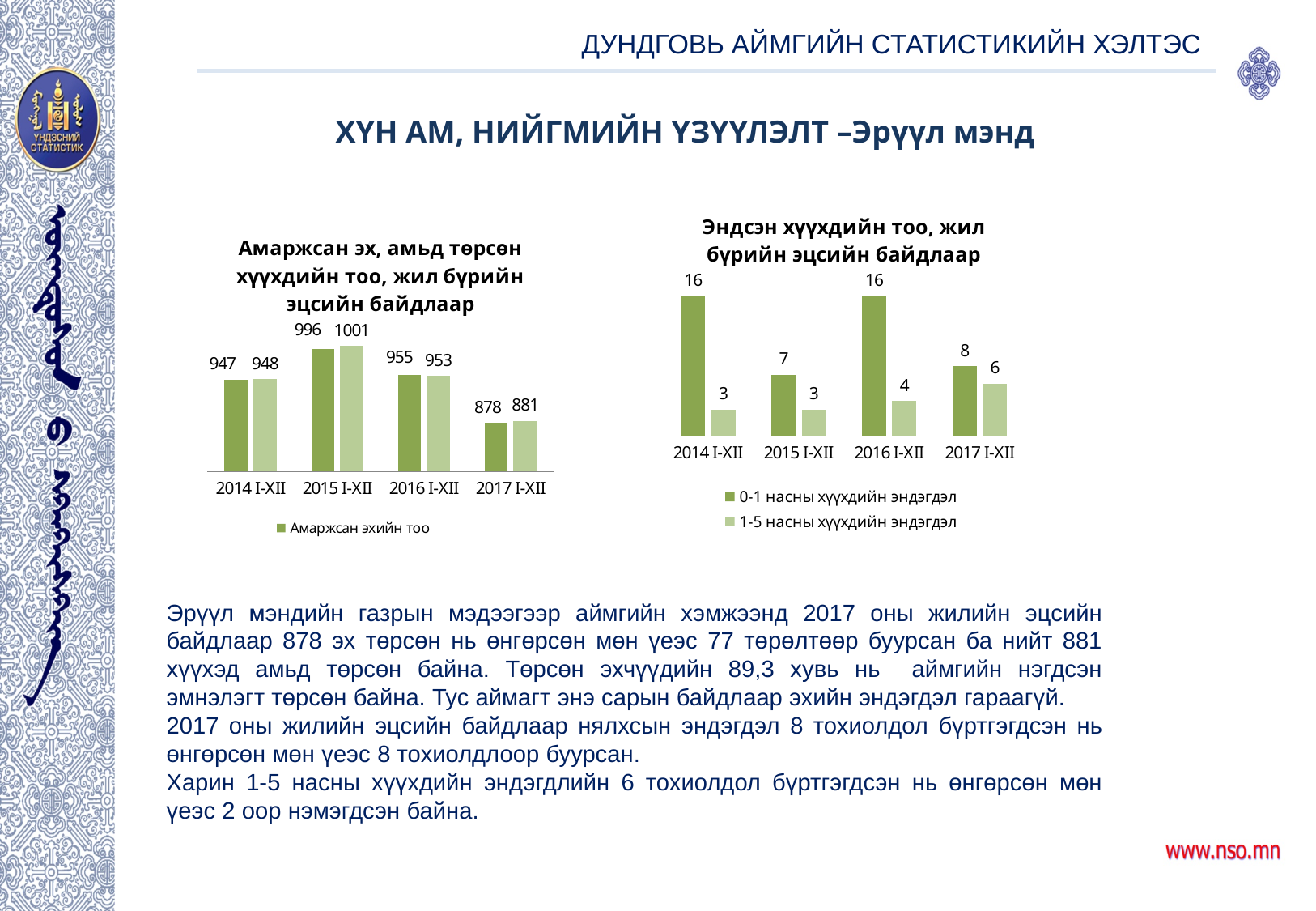
How many series does the legend of the right chart (Эндсэн хүүхдийн тоо) list? 2 In the right chart (Эндсэн хүүхдийн тоо), what is the difference between the 0-1 насны хүүхдийн эндэгдэл values for 2016 I-XII and 2017 I-XII? 8 In the left chart (Амаржсан эх, амьд төрсөн хүүхдийн тоо), which year has the lowest value for Амаржсан эхийн тоо? 2017 I-XII In the right chart (Эндсэн хүүхдийн тоо), which is larger in 2015 I-XII: 0-1 насны хүүхдийн эндэгдэл or 1-5 насны хүүхдийн эндэгдэл? 0-1 насны хүүхдийн эндэгдэл In the right chart (Эндсэн хүүхдийн тоо), which year has the highest value for 1-5 насны хүүхдийн эндэгдэл? 2017 I-XII How many years are shown on the x axis of the right chart (Эндсэн хүүхдийн тоо)? 4 What kind of chart is the left chart (Амаржсан эх, амьд төрсөн хүүхдийн тоо)? Bar chart In the right chart (Эндсэн хүүхдийн тоо), what is the value for 1-5 насны хүүхдийн эндэгдэл in 2016 I-XII? 4 In the left chart (Амаржсан эх, амьд төрсөн хүүхдийн тоо), what is the value for Амаржсан эхийн тоо in 2015 I-XII? 996 In the right chart (Эндсэн хүүхдийн тоо), does the value for 1-5 насны хүүхдийн эндэгдэл rise or fall from 2016 I-XII to 2017 I-XII? Rise In the left chart (Амаржсан эх, амьд төрсөн хүүхдийн тоо), what is the difference between the Амаржсан эхийн тоо values for 2015 I-XII and 2017 I-XII? 118 In the right chart (Эндсэн хүүхдийн тоо), what is the value for 0-1 насны хүүхдийн эндэгдэл in 2017 I-XII? 8